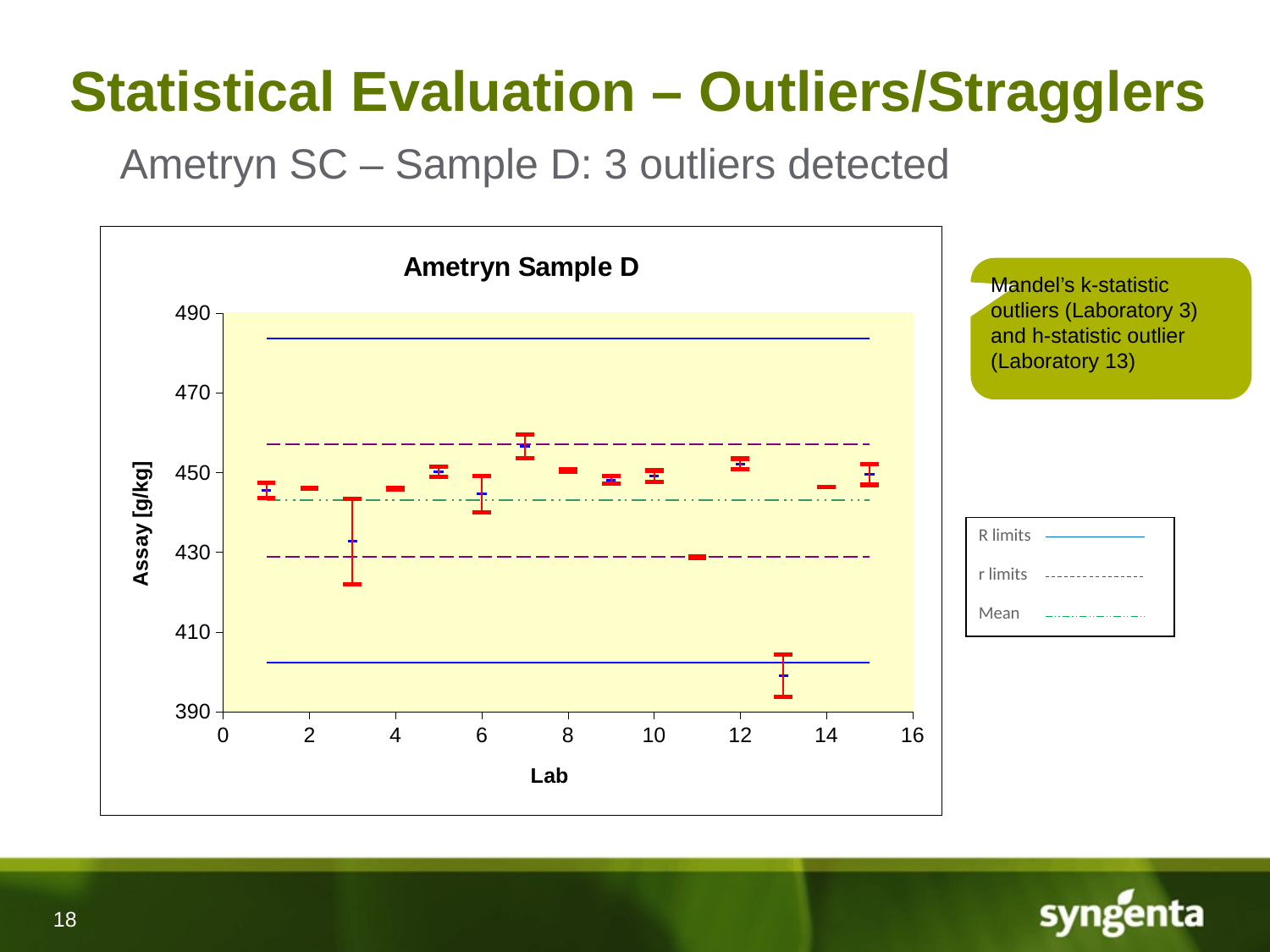
Which has the larger assay value, Lab 3 or Lab 13? Lab 3 Which lab has the lowest assay value in the chart? Lab 13 Which lab has the highest assay value in the chart? Lab 7 Which has the larger assay value, Lab 7 or Lab 11? Lab 7 Is the assay value for Lab 7 greater or less than 450? greater What is the title of the chart? Ametryn Sample D Is the assay value for Lab 3 greater or less than 450? less What is the label of the y axis? Assay [g/kg] Is the assay value for Lab 13 greater or less than 410? less How many laboratories are plotted along the x axis of the chart? 15 What kind of chart is shown on the slide? A scatter chart with error bars How many entries does the chart's legend list? 3